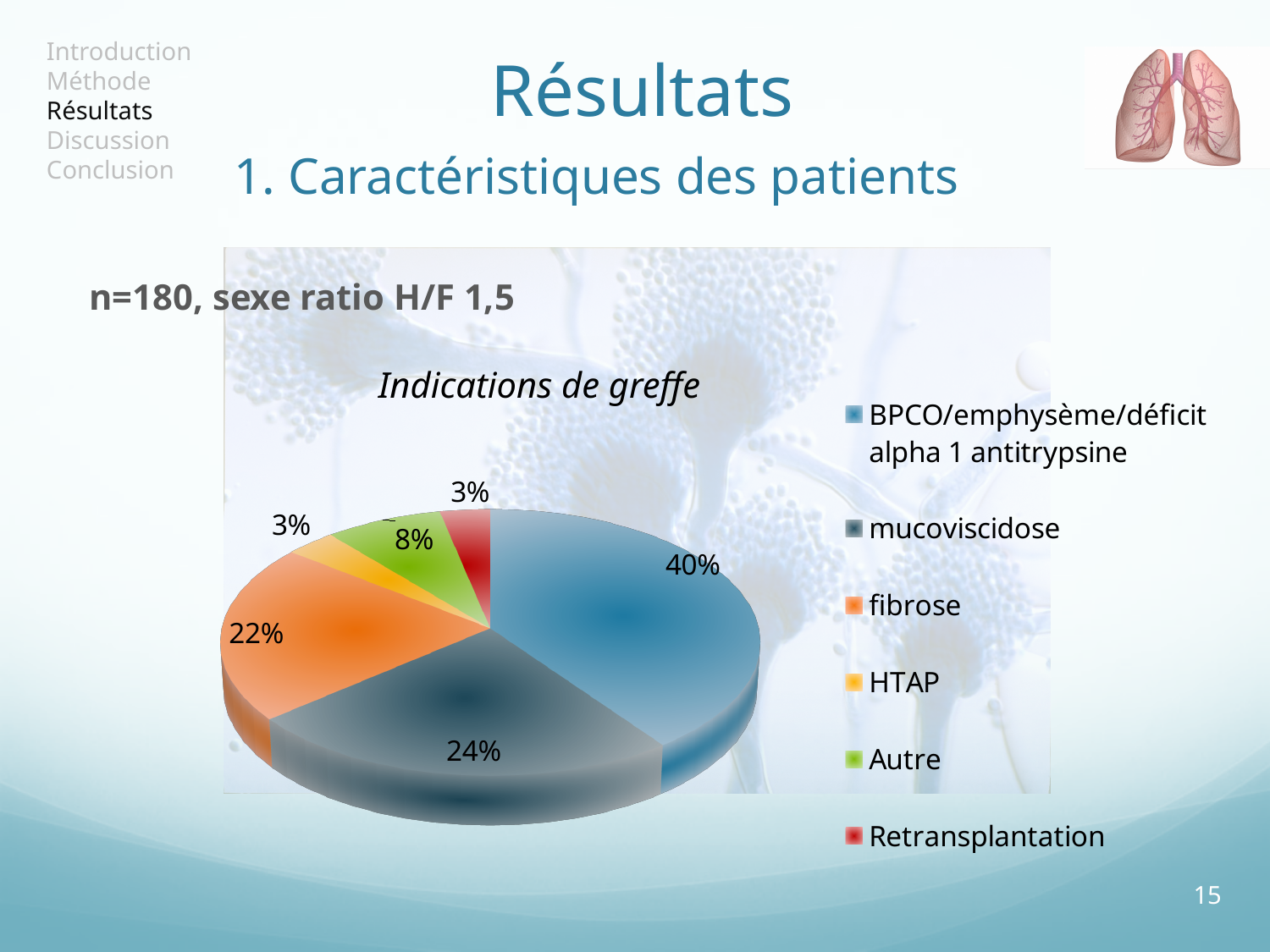
Which category has the largest slice of the pie? BPCO/emphysème/déficit alpha 1 antitrypsine How many categories does the legend of the pie chart list? 6 What share of the pie does fibrose represent? 22% Which colour represents Retransplantation in the pie chart? red What share of the pie does BPCO/emphysème/déficit alpha 1 antitrypsine represent? 40% What is the difference in percentage points between the BPCO/emphysème/déficit alpha 1 antitrypsine slice and the mucoviscidose slice? 16 percentage points What share of the pie does Autre represent? 8% Which slice is larger, fibrose or Autre? fibrose What kind of chart is shown on the slide? pie chart What is the title of the chart? Indications de greffe